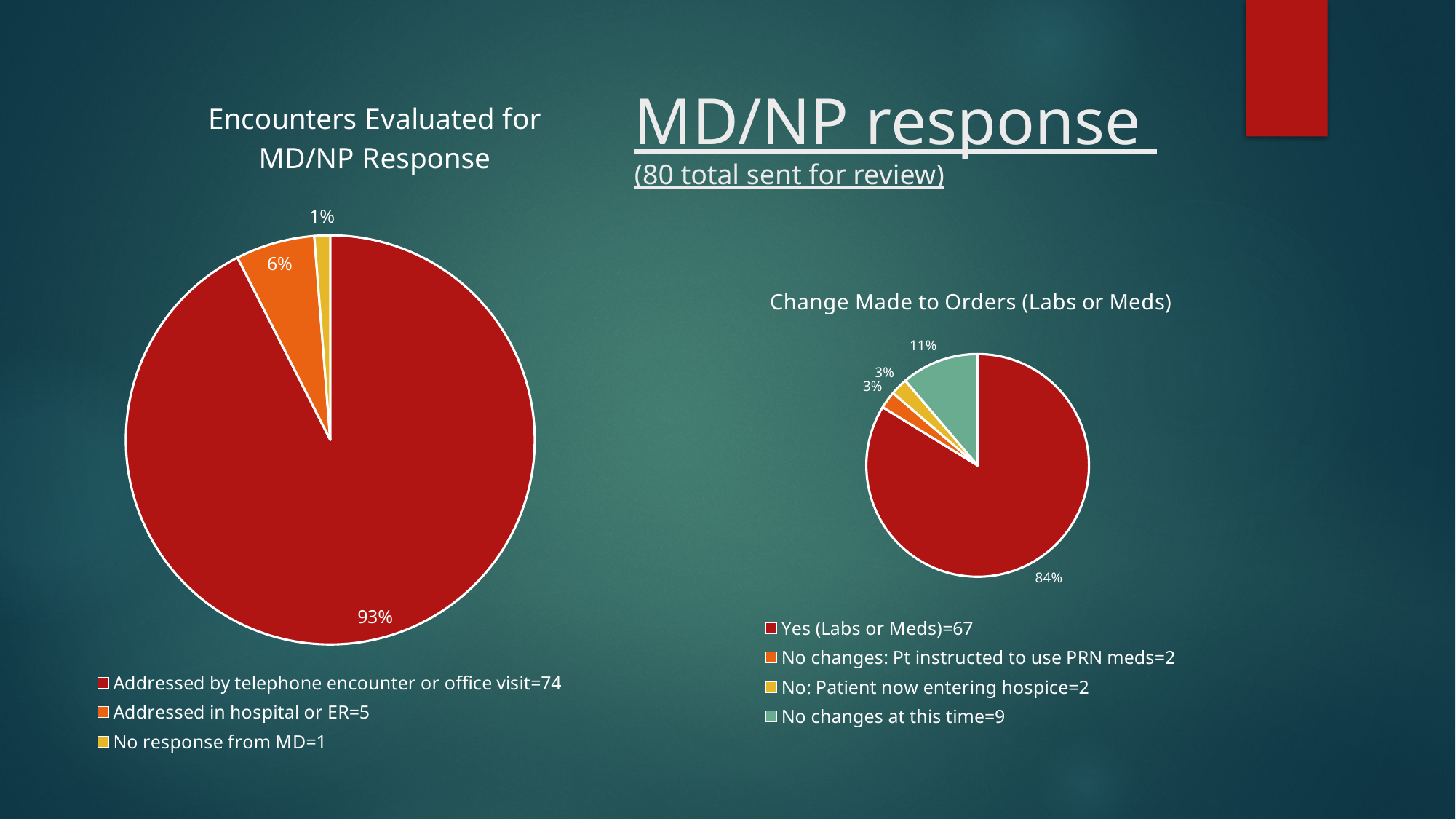
In the 'Encounters Evaluated for MD/NP Response' chart, which category is the smallest? No response from MD In the 'Change Made to Orders (Labs or Meds)' chart, which category is the largest? Yes (Labs or Meds) In the 'Encounters Evaluated for MD/NP Response' chart, how many categories does the legend list? 3 In the 'Encounters Evaluated for MD/NP Response' chart, what share of the pie is 'Addressed by telephone encounter or office visit'? 93% What kind of chart is 'Encounters Evaluated for MD/NP Response'? Pie chart In the 'Change Made to Orders (Labs or Meds)' chart, which is larger: 'No changes at this time' or 'No: Patient now entering hospice'? No changes at this time In the 'Encounters Evaluated for MD/NP Response' chart, what share of the pie is 'Addressed in hospital or ER'? 6% In the 'Change Made to Orders (Labs or Meds)' chart, what share of the pie is 'No changes at this time'? 11% In the 'Change Made to Orders (Labs or Meds)' chart, what is the difference in percentage points between 'Yes (Labs or Meds)' and 'No changes at this time'? 73 In the 'Change Made to Orders (Labs or Meds)' chart, how many categories does the legend list? 4 In the 'Encounters Evaluated for MD/NP Response' chart, what colour is the 'No response from MD' slice? Yellow